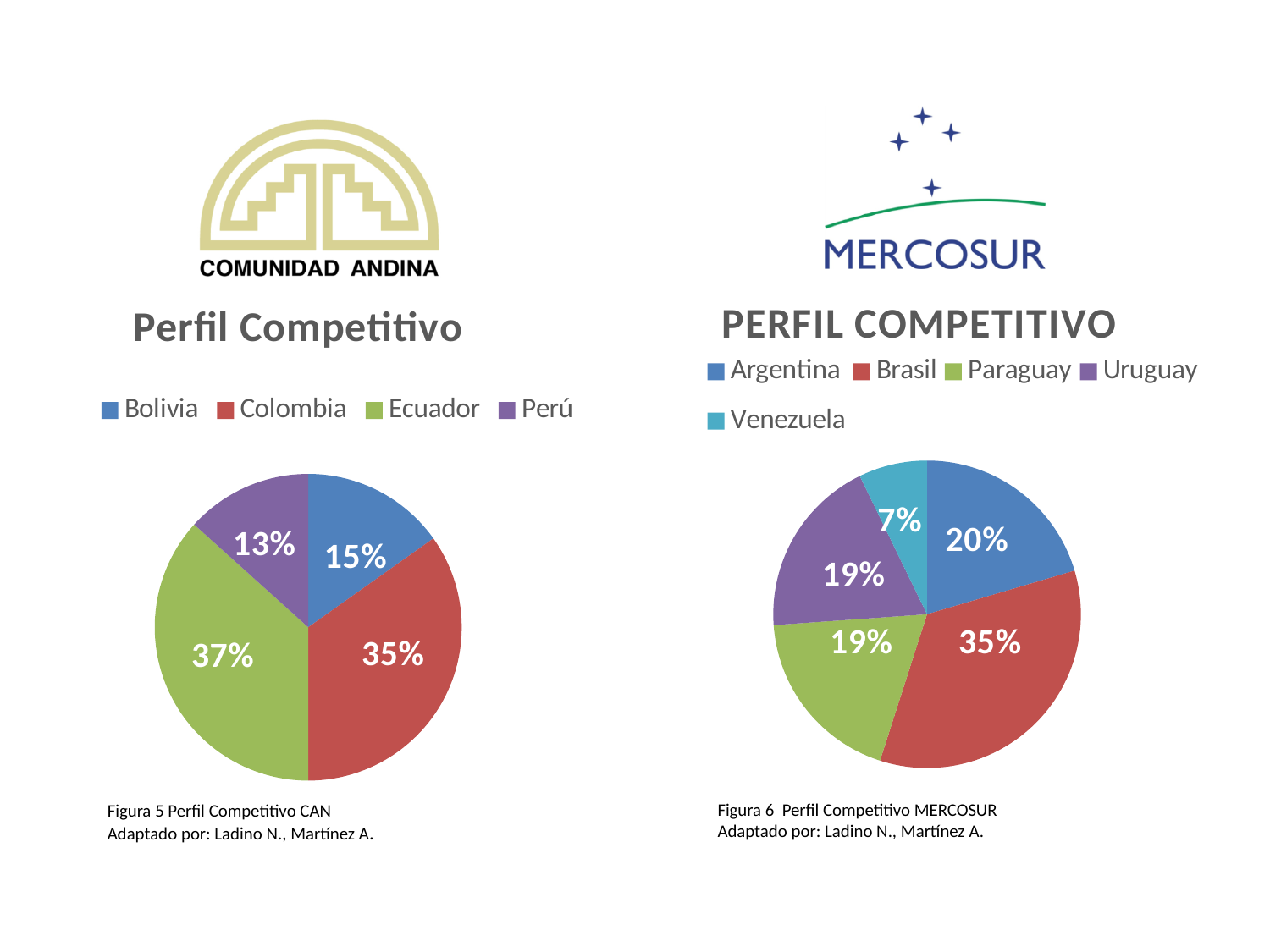
In the left pie chart (Comunidad Andina), which country has the largest share? Ecuador In the right pie chart (MERCOSUR), how many entries does the legend list? 5 In the left pie chart (Comunidad Andina), what is the difference between Ecuador's share and Bolivia's share? 22% In the right pie chart (MERCOSUR), which is larger, Argentina's share or Uruguay's share? Argentina In the right pie chart (MERCOSUR), which country has the largest share? Brasil In the left pie chart (Comunidad Andina), how many countries are shown? 4 What type of chart is the right chart (MERCOSUR)? Pie chart In the right pie chart (MERCOSUR), what share does Argentina have? 20% In the left pie chart (Comunidad Andina), what share does Colombia have? 35% In the left pie chart (Comunidad Andina), which country has the smallest share? Perú In the left pie chart (Comunidad Andina), what share does Perú have? 13% In the right pie chart (MERCOSUR), what share does Venezuela have? 7%